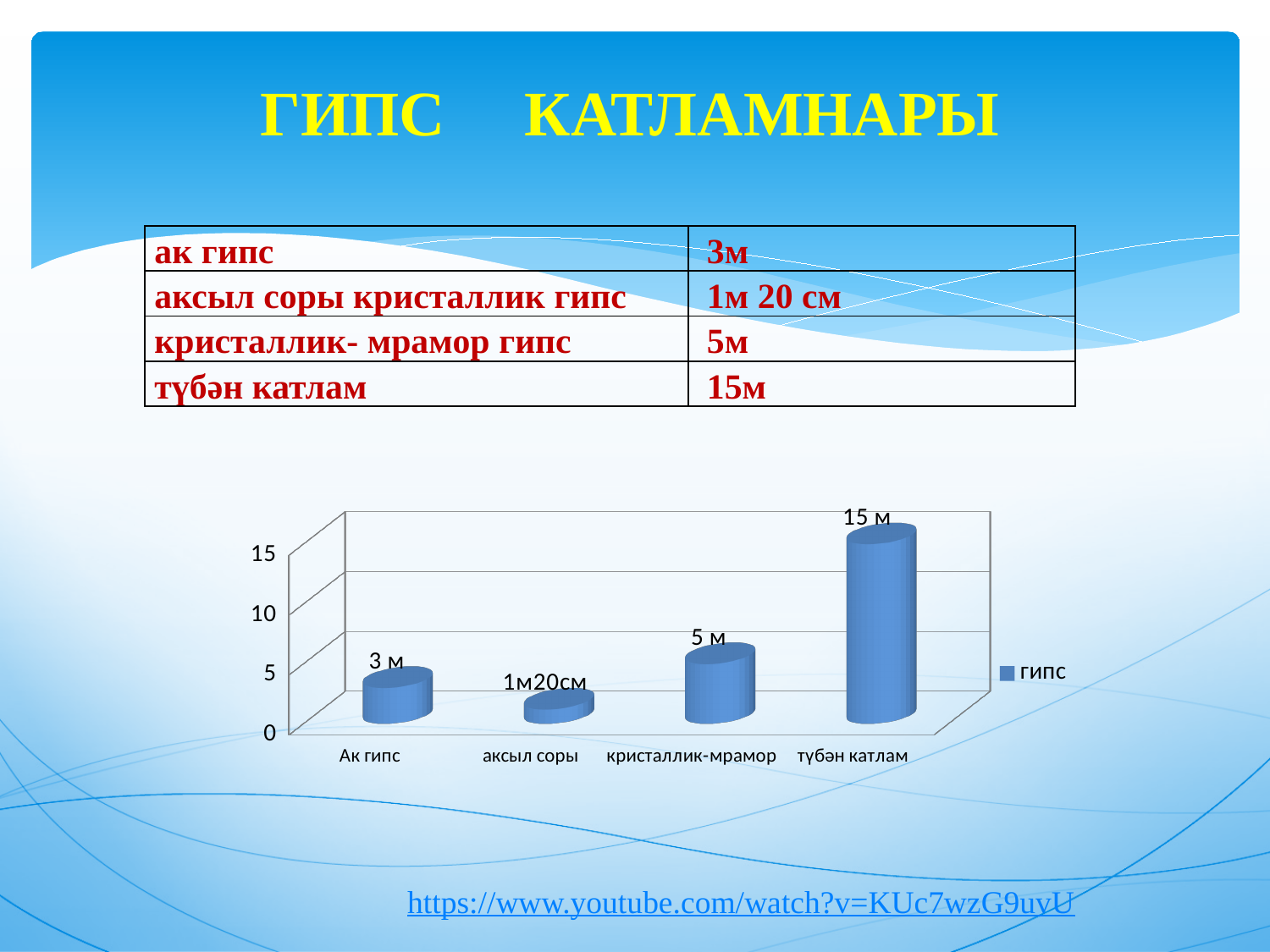
What is the value shown for кристаллик-мрамор? 5 м Is the value for түбән катлам greater or less than 10? greater Which is larger, the value for кристаллик-мрамор or the value for Ак гипс? кристаллик-мрамор What kind of chart is shown on the slide? bar chart What is the value shown for Ак гипс? 3 м How many series does the legend list? 1 What is the value shown for аксыл соры? 1м20см What is the value shown for түбән катлам? 15 м What is the difference between the values for түбән катлам and кристаллик-мрамор? 10 м Which category has the lowest value? аксыл соры How many categories are shown on the x axis? 4 Which category has the highest value? түбән катлам